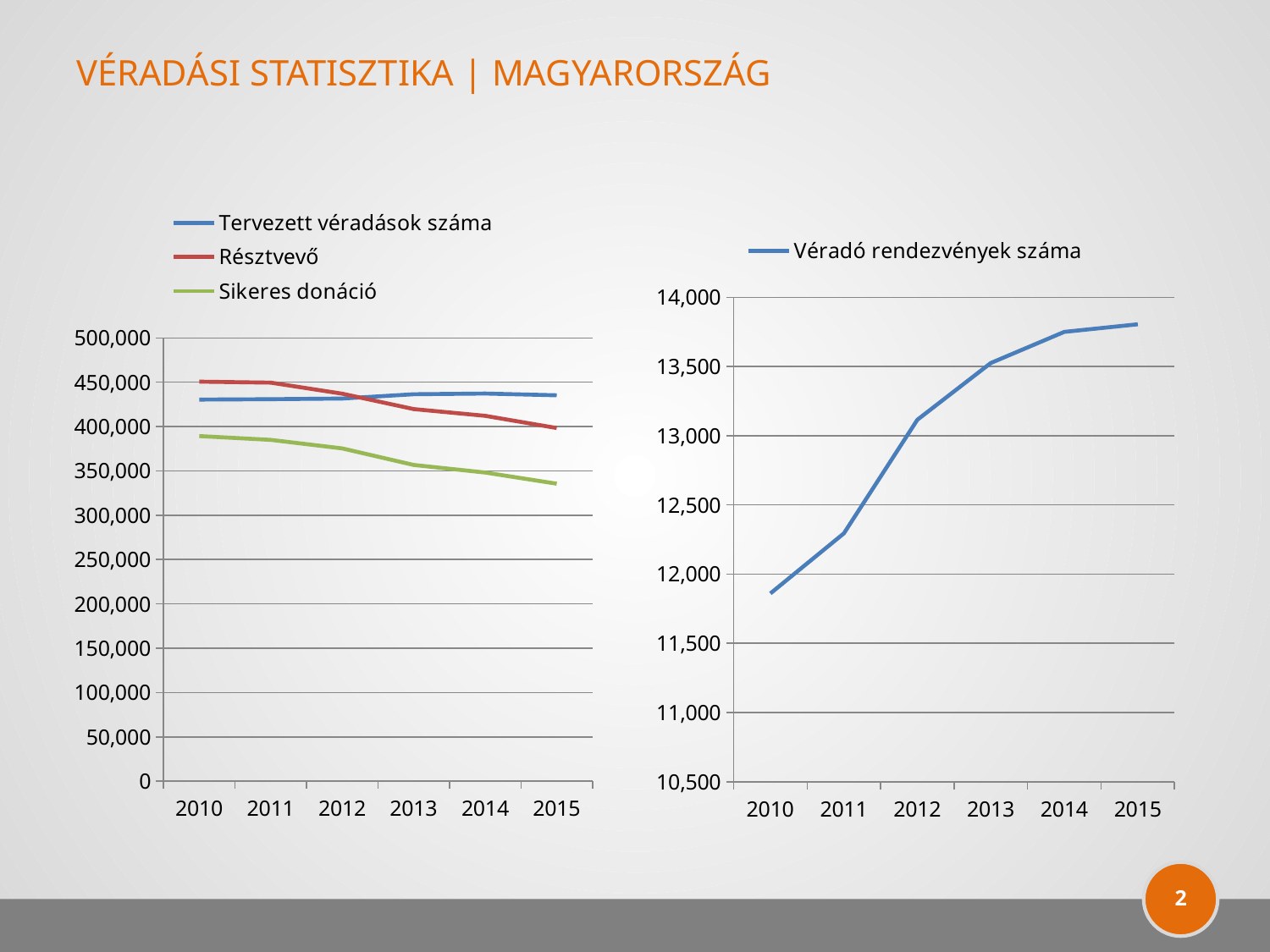
What kind of chart is the left chart on the slide? line chart How many series does the legend of the left chart list? 3 In the right chart (Véradó rendezvények száma), do the values rise or fall from 2010 to 2015? rise In the left chart, does the Sikeres donáció series rise or fall from 2010 to 2015? fall In the left chart, is the value of Sikeres donáció for 2015 greater or less than 350,000? less In the right chart (Véradó rendezvények száma), is the value for 2015 greater or less than 13,500? greater In the left chart, which is larger in 2015: Tervezett véradások száma or Résztvevő? Tervezett véradások száma In the right chart (Véradó rendezvények száma), which year has the lowest value? 2010 How many years are shown on the x axis of the right chart (Véradó rendezvények száma)? 6 In the right chart (Véradó rendezvények száma), is the value for 2010 greater or less than 12,000? less In the right chart (Véradó rendezvények száma), which year has the highest value? 2015 In the left chart, which series has the lowest values across all years? Sikeres donáció